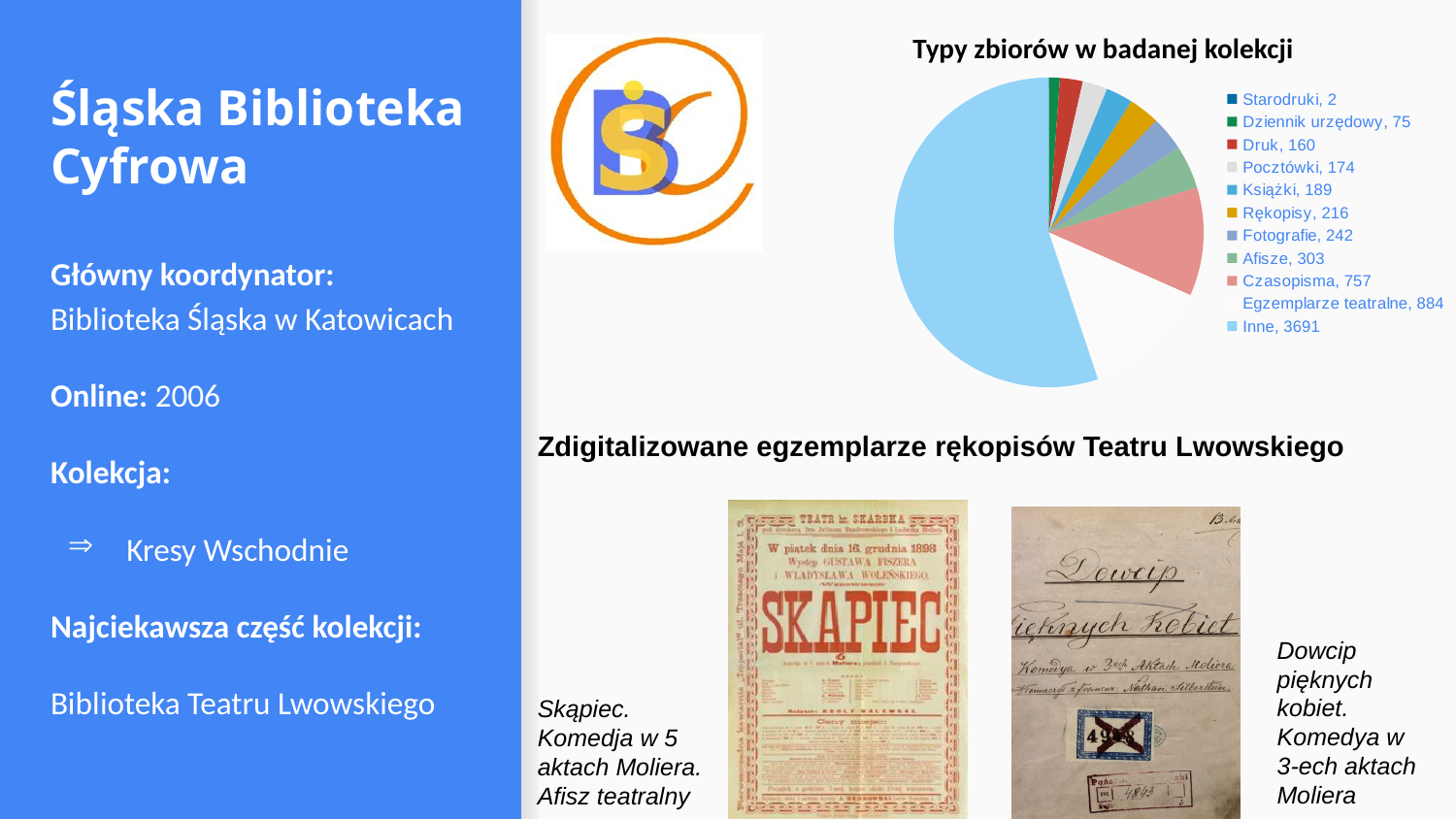
What type of chart is shown under the title "Typy zbiorów w badanej kolekcji"? pie chart Which category has the largest value in the pie chart? Inne What is the value for Czasopisma in the pie chart? 757 What is the value for Dziennik urzędowy in the pie chart? 75 What is the difference between the values for Egzemplarze teatralne and Czasopisma in the pie chart? 127 What is the value for Rękopisy in the pie chart? 216 Which is larger in the pie chart, Fotografie or Afisze? Afisze What is the value for Egzemplarze teatralne in the pie chart? 884 How many categories does the pie chart show? 11 What is the difference between the values for Książki and Pocztówki in the pie chart? 15 Which category has the smallest value in the pie chart? Starodruki What is the title of the pie chart? Typy zbiorów w badanej kolekcji